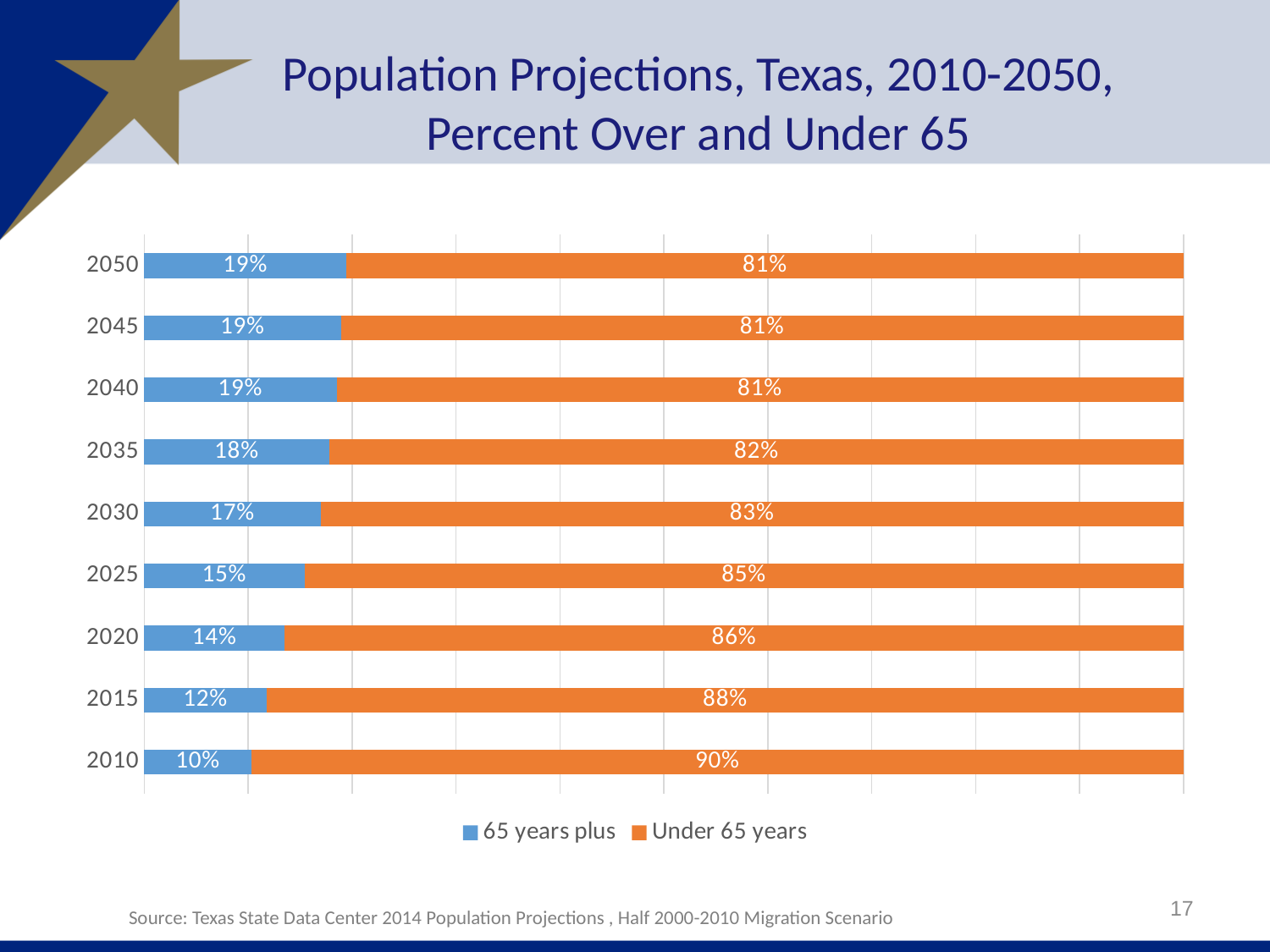
Which year has the highest under 65 years share? 2010 Which colour represents the under 65 years series? Orange What percentage of the Texas population is projected to be 65 years plus in 2030? 17% Which year has the lowest 65 years plus share? 2010 How many series does the legend list? 2 Which is larger, the 65 years plus share in 2025 or in 2035? 2035 What percentage of the Texas population is projected to be under 65 years in 2015? 88% Does the 65 years plus share rise or fall from 2010 to 2050? Rise What is the 65 years plus share shown for 2010? 10% What kind of chart is shown on the slide? Stacked bar chart By how many percentage points does the 65 years plus share in 2050 exceed that in 2010? 9 percentage points How many years are shown on the chart? 9